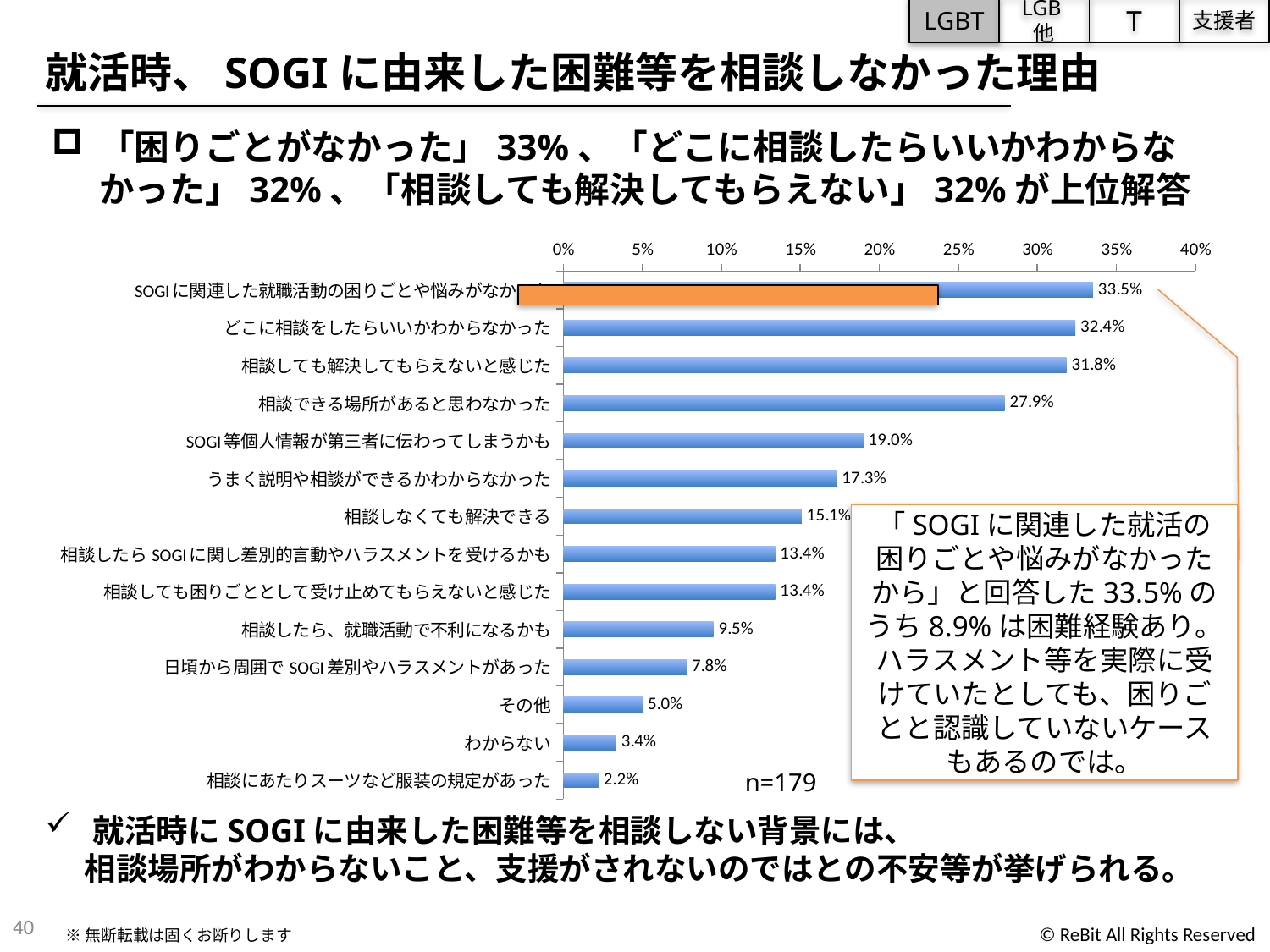
What is the value for 「どこに相談をしたらいいかわからなかった」? 32.4% Is the value for 「相談しても解決してもらえないと感じた」 greater or less than 30%? greater Which category has the highest value in the chart? SOGIに関連した就職活動の困りごとや悩みがなかった (33.5%) What is the value for 「その他」? 5.0% What is the sample size (n) shown on the chart? n=179 How many categories are plotted in the chart? 14 What type of chart is shown on the slide? Bar chart What is the difference between 「SOGI等個人情報が第三者に伝わってしまうかも」 and 「うまく説明や相談ができるかわからなかった」? 1.7% What is the value for 「相談できる場所があると思わなかった」? 27.9% Which is larger: 「相談しなくても解決できる」 or 「相談したら、就職活動で不利になるかも」? 相談しなくても解決できる What is the value for 「相談にあたりスーツなど服装の規定があった」? 2.2% Which category has the lowest value in the chart? 相談にあたりスーツなど服装の規定があった (2.2%)